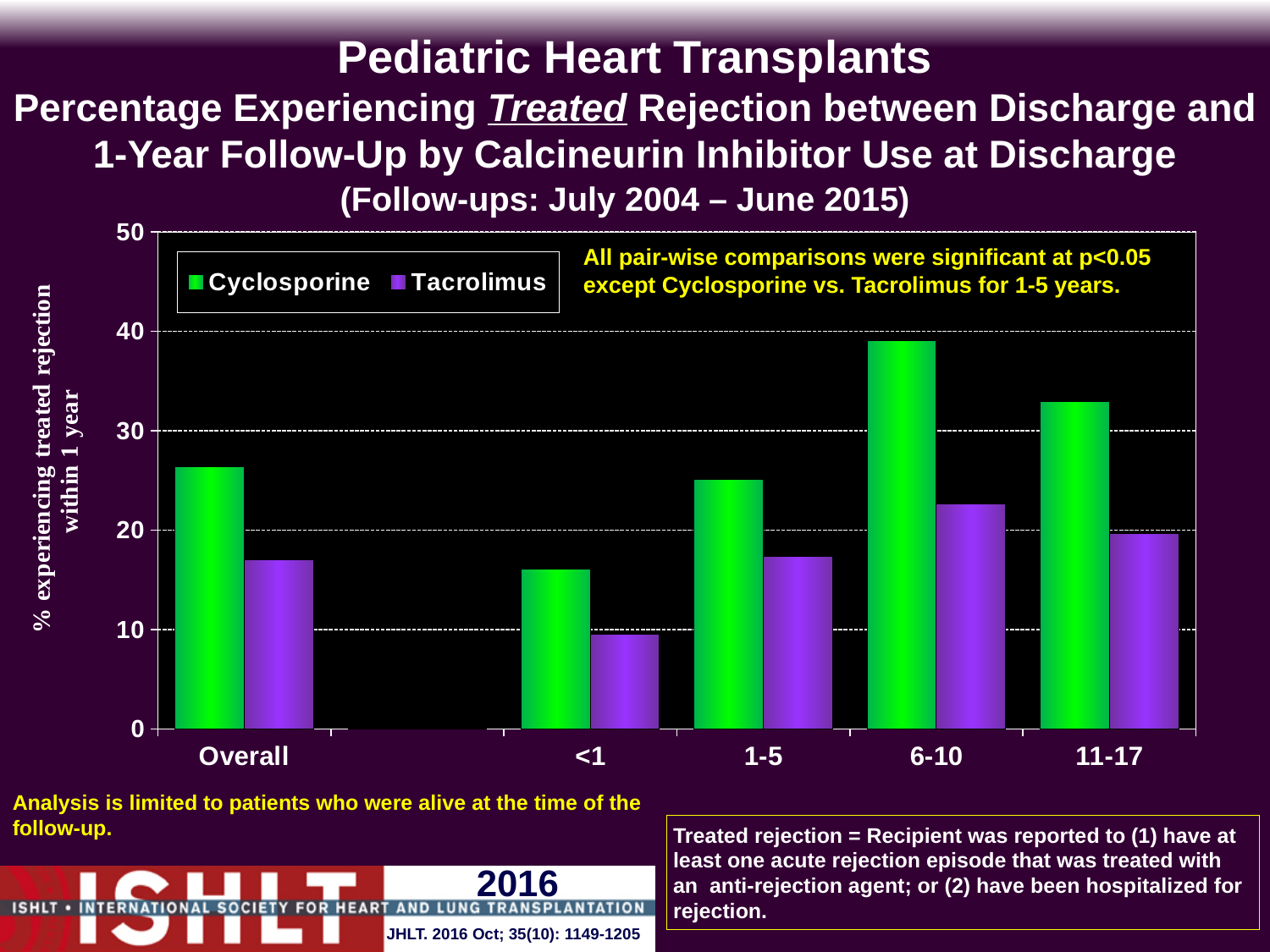
Is the Tacrolimus value for the Overall category greater or less than 20? less What kind of chart is shown on the slide? bar chart In the 11-17 age group, which series has the larger value, Cyclosporine or Tacrolimus? Cyclosporine Is the Cyclosporine value for the 6-10 age group greater or less than 30? greater For which age category is the Cyclosporine bar highest? 6-10 How many categories are shown on the x axis? 5 For which age category is the Tacrolimus bar lowest? <1 Which colour represents Tacrolimus in the legend? purple For which age category is the Tacrolimus bar highest? 6-10 How many series does the legend list? 2 For which age category is the Cyclosporine bar lowest? <1 Is the Cyclosporine value for the <1 age group greater or less than 20? less